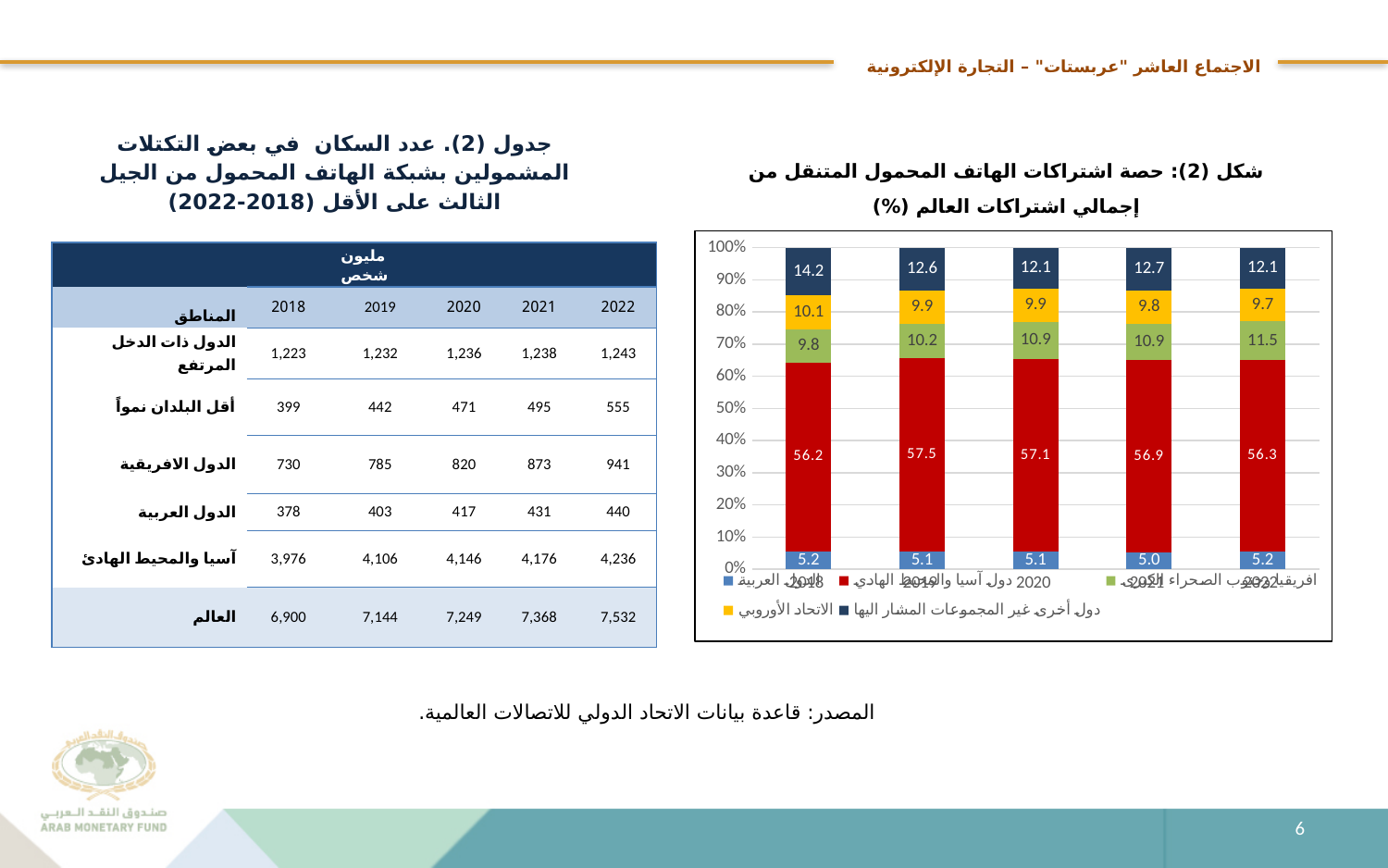
What is the difference between the الاتحاد الأوروبي value in 2018 and in 2019? 1.6 How many series does the chart legend list? 5 What is the value for الاتحاد الأوروبي in 2018? 14.2 What is the value for افريقيا جنوب الصحراء الكبرى in 2022? 11.5 In which year is the value for الاتحاد الأوروبي lowest? 2020 and 2022 (12.1) Which is larger in 2020: the value for افريقيا جنوب الصحراء الكبرى or the value for دول أخرى غير المجموعات المشار اليها? افريقيا جنوب الصحراء الكبرى Does the value for افريقيا جنوب الصحراء الكبرى rise or fall from 2018 to 2022? rise What is the value for الدول العربية in 2021? 5.0 What type of chart is shown on the slide? stacked bar chart In which year is the value for دول آسيا والمحيط الهادي highest? 2019 What is the value for دول آسيا والمحيط الهادي in 2019? 57.5 How many years (bars) are shown on the chart's x axis? 5